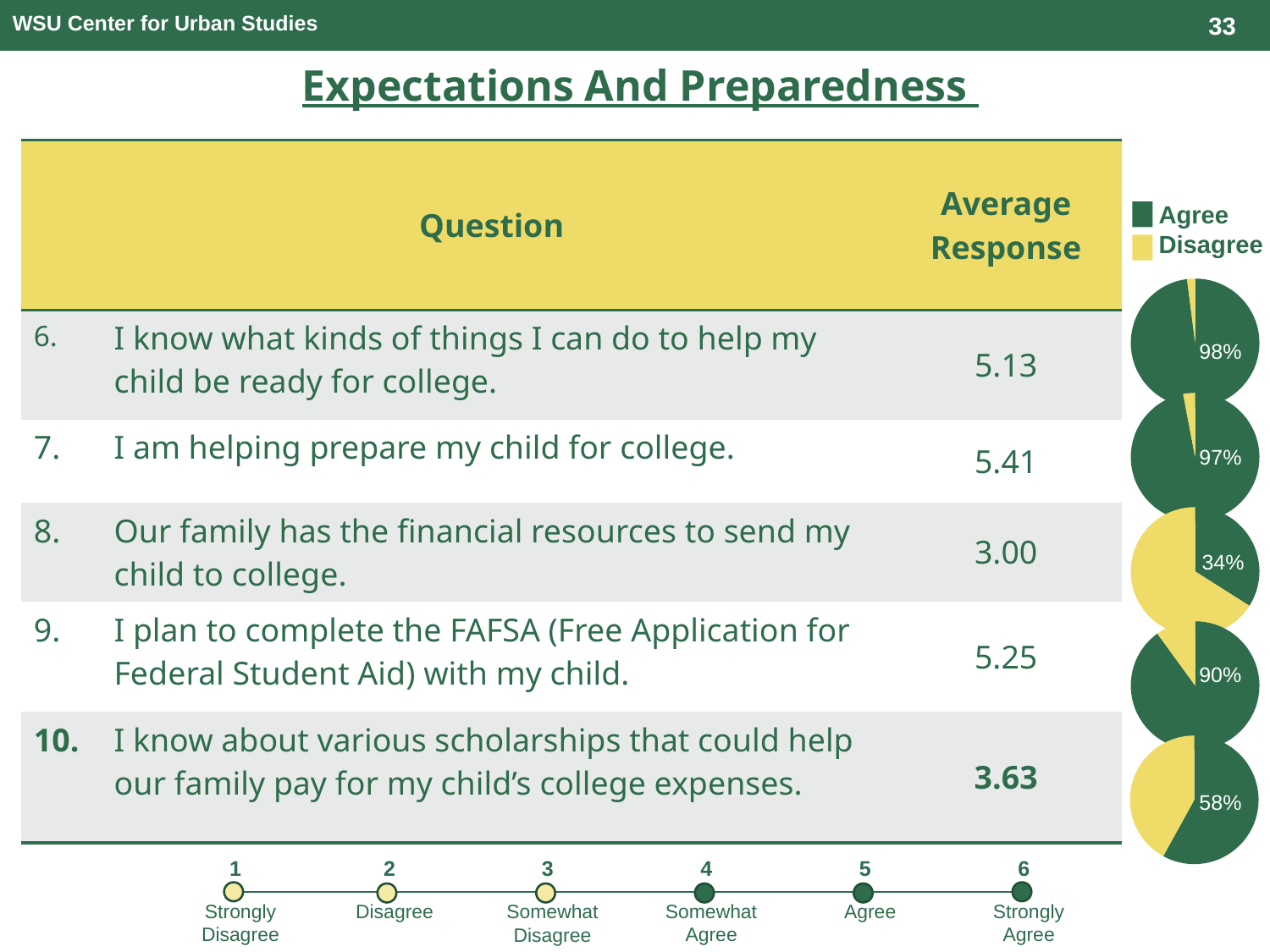
In the pie chart next to question 9 (about completing the FAFSA), what is the Agree percentage? 90% What is the difference in Agree percentage between the pie chart for question 6 and the pie chart for question 8? 64 percentage points Across the five pie charts on the right of the slide, which question has the lowest Agree percentage? Question 8 (34%) How many pie charts are shown on the right side of the slide? 5 In the pie chart next to question 6 ("I know what kinds of things I can do to help my child be ready for college"), what percentage of respondents Agree? 98% In the pie chart next to question 10 (about knowing various scholarships), what is the Agree percentage? 58% How many categories does the legend for the pie charts list? 2 What type of chart is used on the right side of the slide to show Agree versus Disagree? Pie chart Which pie chart shows a larger Agree share: the one for question 9 or the one for question 10? Question 9 Across the five pie charts on the right of the slide, which question has the highest Agree percentage? Question 6 (98%) In the pie chart next to question 7 ("I am helping prepare my child for college"), what is the Agree percentage? 97% In the pie chart next to question 8 ("Our family has the financial resources to send my child to college"), what is the Agree percentage? 34%